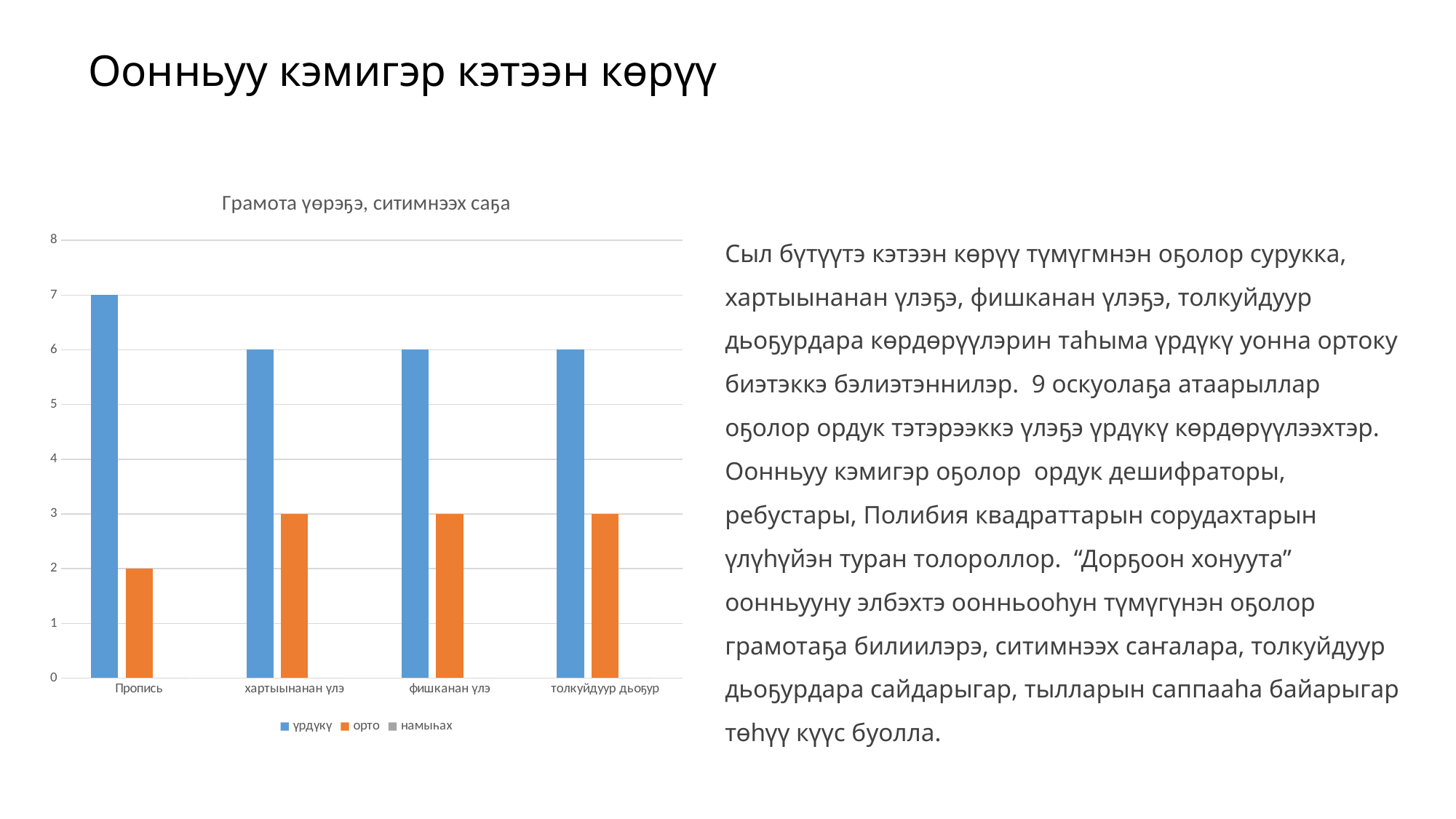
Which is larger for Пропись: the үрдүкү value or the орто value? үрдүкү How many categories are shown on the x axis? 4 What is the difference between the үрдүкү and орто values for хартыынанан үлэ? 3 Which category has the lowest орто value? Пропись What is the value of the орто series for толкуйдуур дьоҕур? 3 What is the title of the chart? Грамота үөрэҕэ, ситимнээх саҕа How many series does the legend list? 3 What is the value of the үрдүкү series for Пропись? 7 What is the value of the үрдүкү series for фишканан үлэ? 6 Which category has the highest үрдүкү value? Пропись What is the value of the орто series for Пропись? 2 What kind of chart is shown on the slide? Bar chart